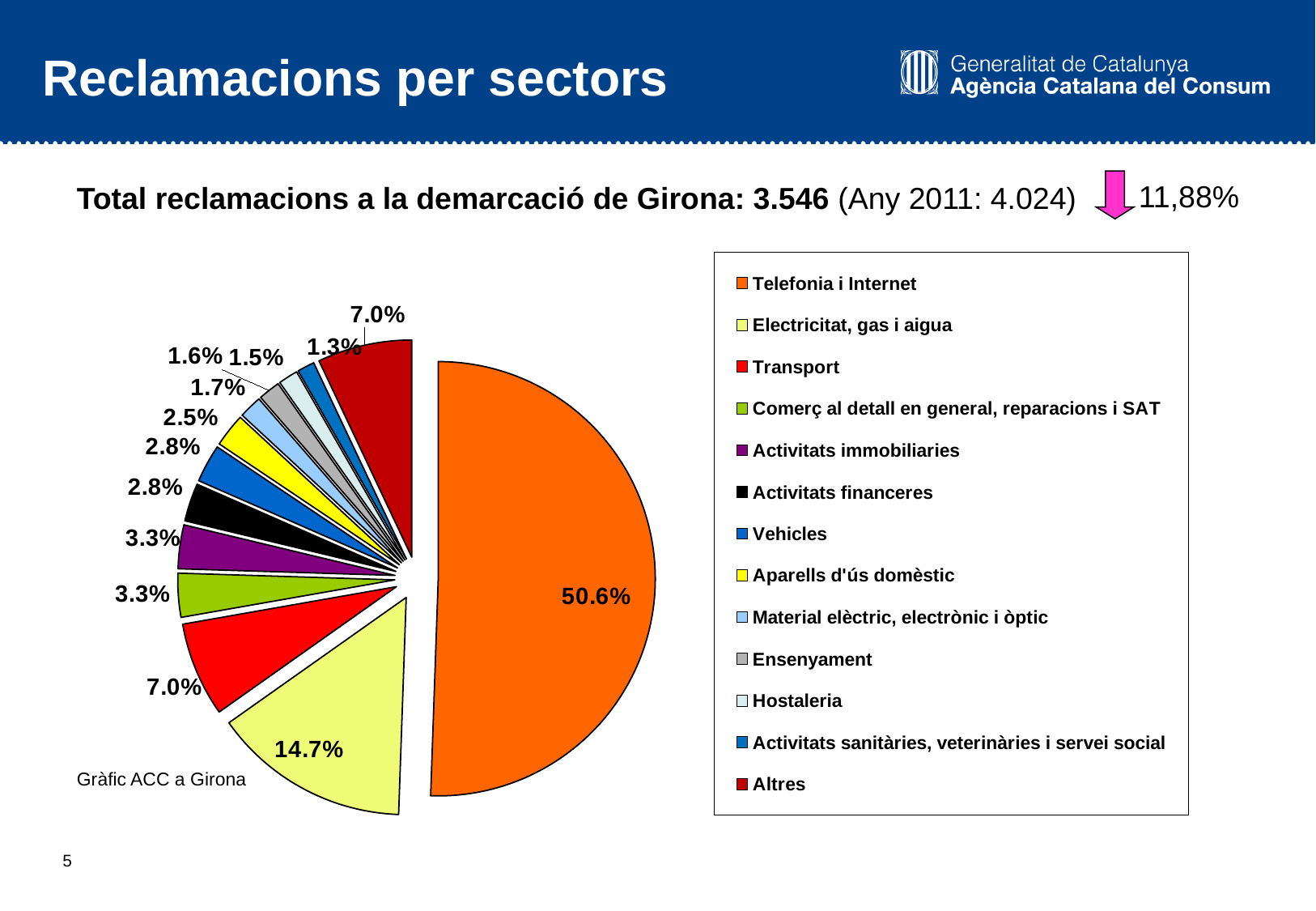
What share of the pie does Aparells d'ús domèstic have? 2.5% What kind of chart is shown on the slide? pie chart Which is larger, the slice for Electricitat, gas i aigua or the slice for Transport? Electricitat, gas i aigua What share of the pie does Transport have? 7.0% Which sector has the largest slice of the pie? Telefonia i Internet What share of the pie does Altres have? 7.0% What is the difference in percentage points between Telefonia i Internet and Electricitat, gas i aigua? 35.9 What share of the pie does Telefonia i Internet have? 50.6% How many sectors does the legend list? 13 Which sector has the smallest slice of the pie? Activitats sanitàries, veterinàries i servei social What share of the pie does Ensenyament have? 1.6% What share of the pie does Electricitat, gas i aigua have? 14.7%